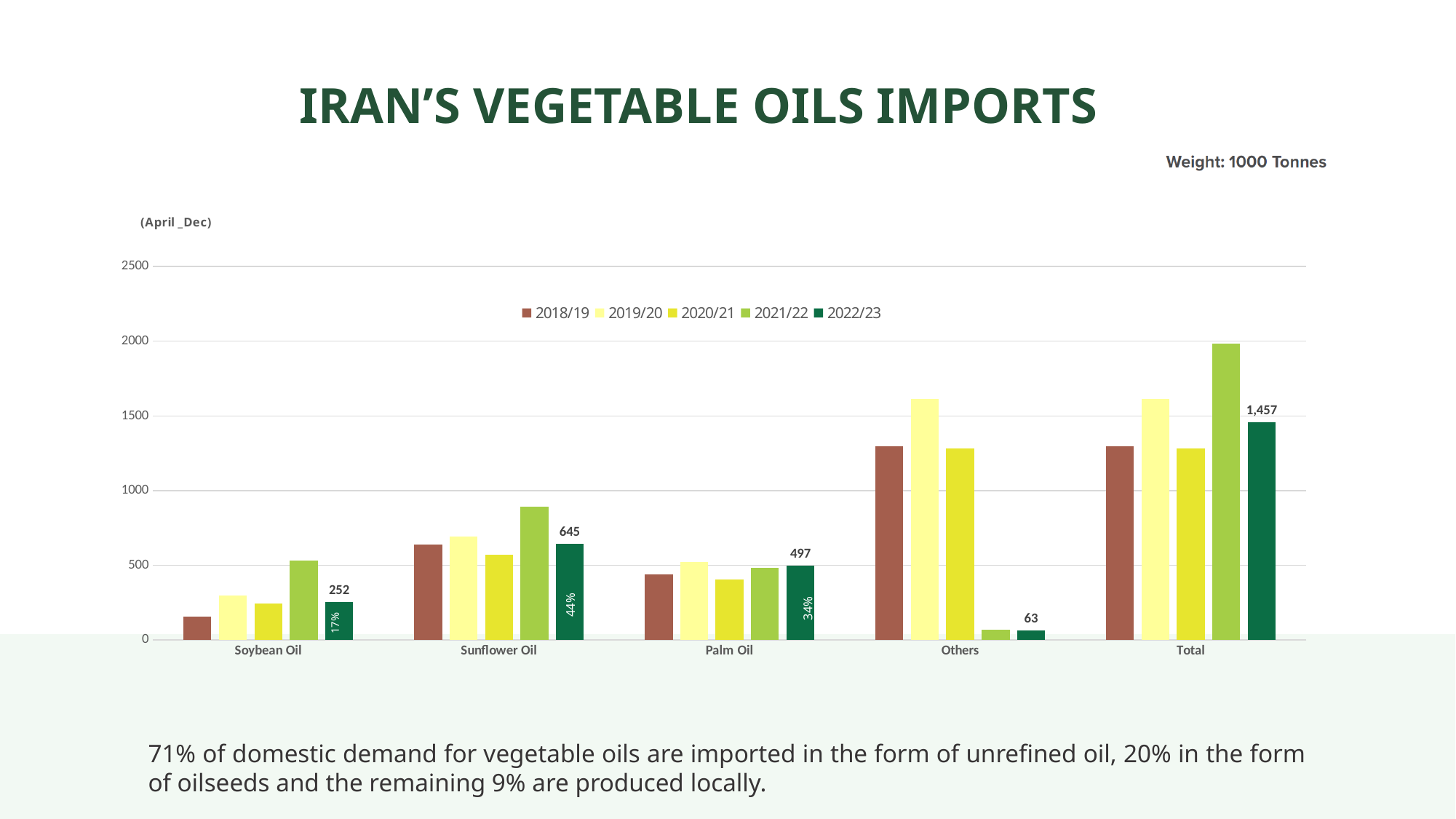
What is the value for Others in 2022/23? 63 Which category has the lowest value in 2022/23? Others What is the difference between the 2022/23 values for Sunflower Oil and Palm Oil? 148 How many series does the legend list? 5 Is the value for Total in 2021/22 greater or less than 1500? greater Excluding Total, which category has the highest value in 2022/23? Sunflower Oil How many categories are shown on the x axis? 5 In 2022/23, which is larger: Palm Oil or Soybean Oil? Palm Oil What kind of chart is shown on the slide? bar chart What is the value for Total in 2022/23? 1,457 What is the value for Sunflower Oil in 2022/23? 645 What is the value for Soybean Oil in 2022/23? 252